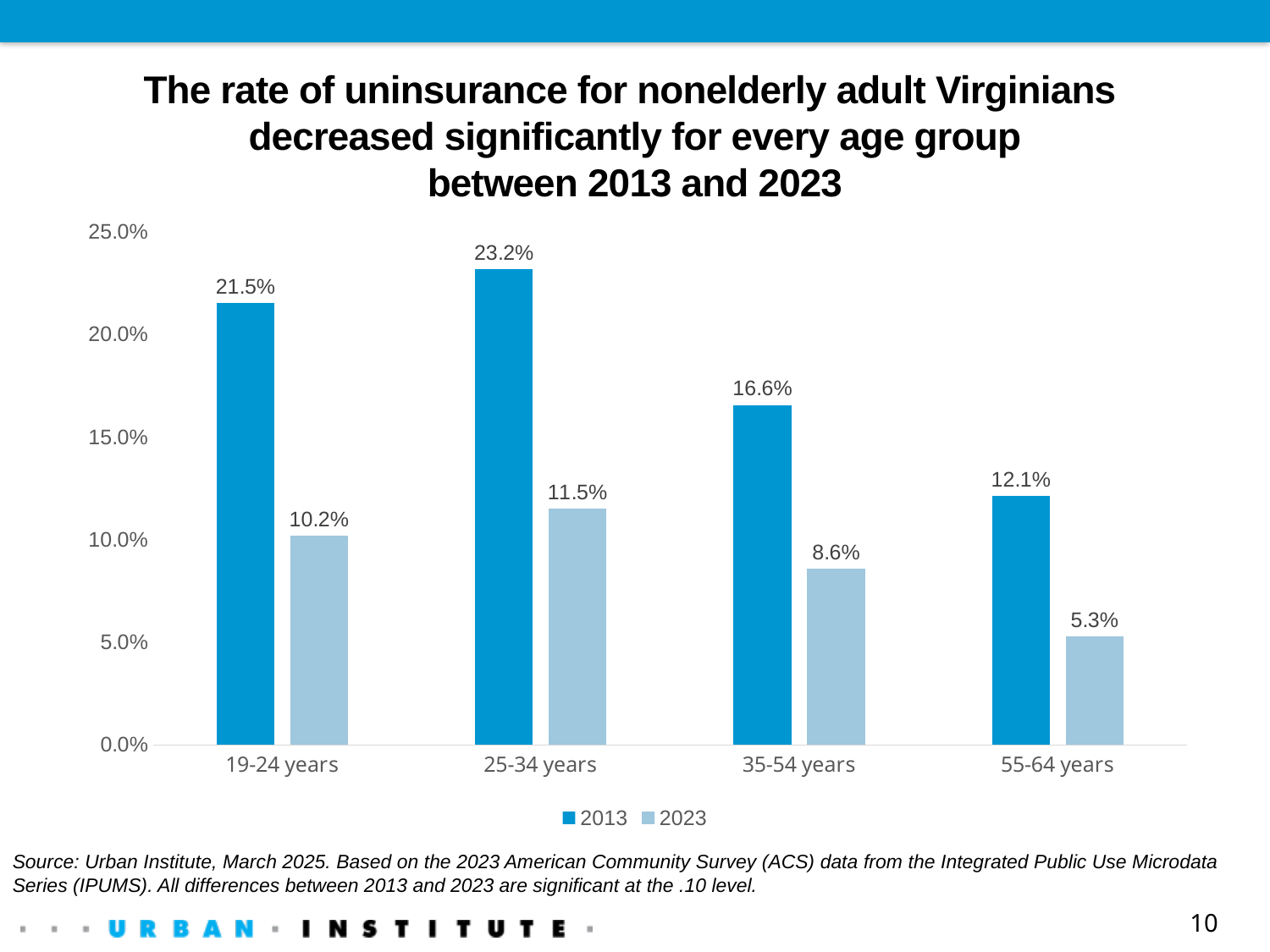
Which is larger: the 2023 rate for 19-24 years or the 2023 rate for 25-34 years? 25-34 years What was the uninsurance rate for 55-64 years in 2023? 5.3% How many age groups are shown on the chart? 4 How many series does the legend list? 2 Which year does the lighter blue bar represent in the legend? 2023 Which age group had the highest uninsurance rate in 2013? 25-34 years What is the difference between the 2013 and 2023 uninsurance rates for 55-64 years? 6.8 percentage points What was the uninsurance rate for 19-24 years in 2013? 21.5% What is the difference between the 2013 and 2023 uninsurance rates for 25-34 years? 11.7 percentage points Which age group had the lowest uninsurance rate in 2023? 55-64 years What was the uninsurance rate for 35-54 years in 2023? 8.6% What kind of chart is shown on the slide? Bar chart